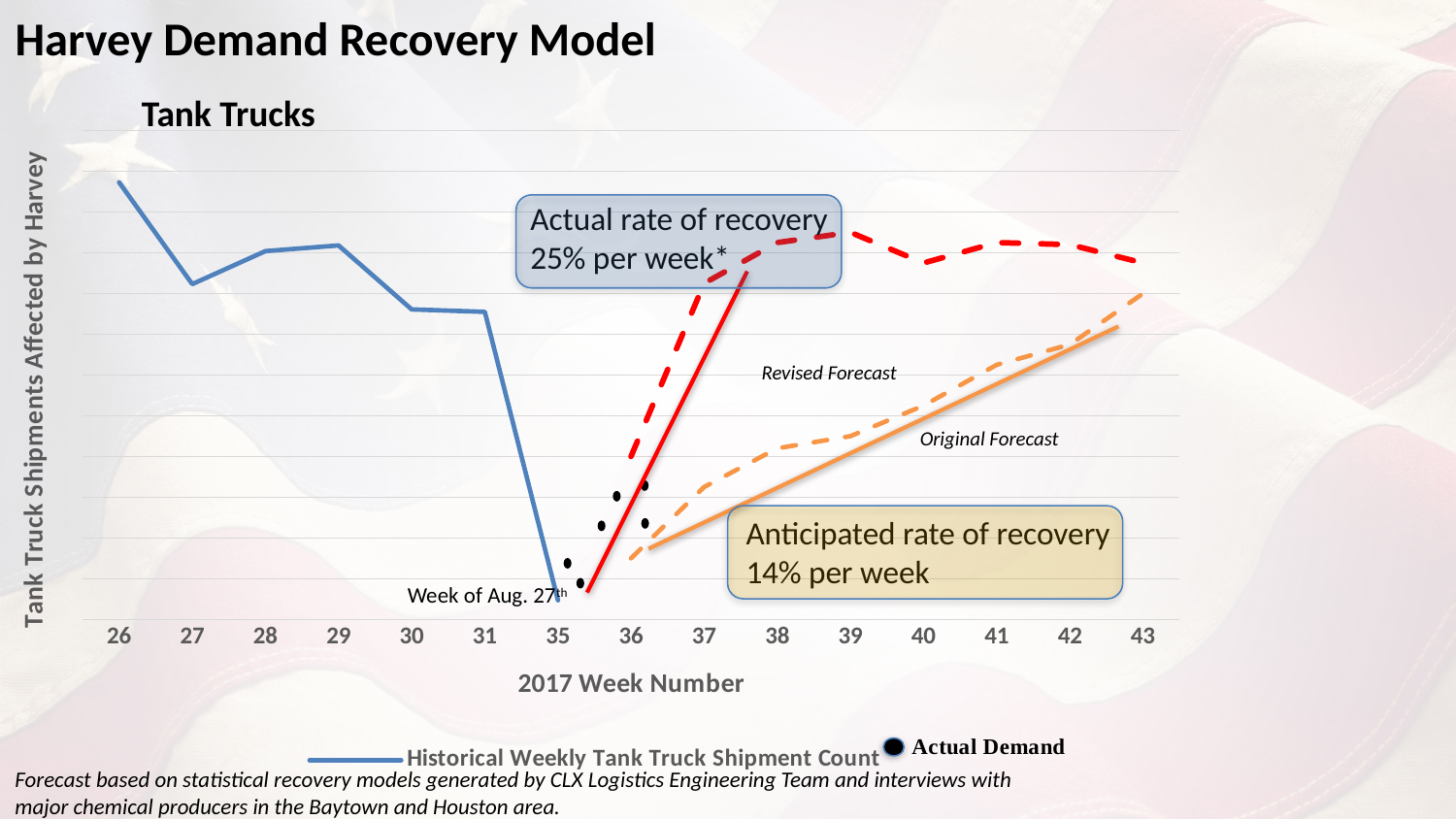
At which week number is the historical weekly tank truck shipment count highest? 26 What is the anticipated rate of recovery stated on the chart? 14% per week How many week numbers are labelled on the x axis? 15 What kind of chart is shown on the slide? line chart What is the title of the chart? Tank Trucks Does the historical weekly tank truck shipment count rise or fall between week 31 and week 35? fall Is the historical shipment count higher at week 28 or at week 30? week 28 What is the actual rate of recovery stated on the chart? 25% per week At which week number does the historical weekly tank truck shipment count reach its lowest point? 35 By how many percentage points does the actual rate of recovery exceed the anticipated rate of recovery? 11 How many entries does the legend list? 2 What is the label of the x axis? 2017 Week Number